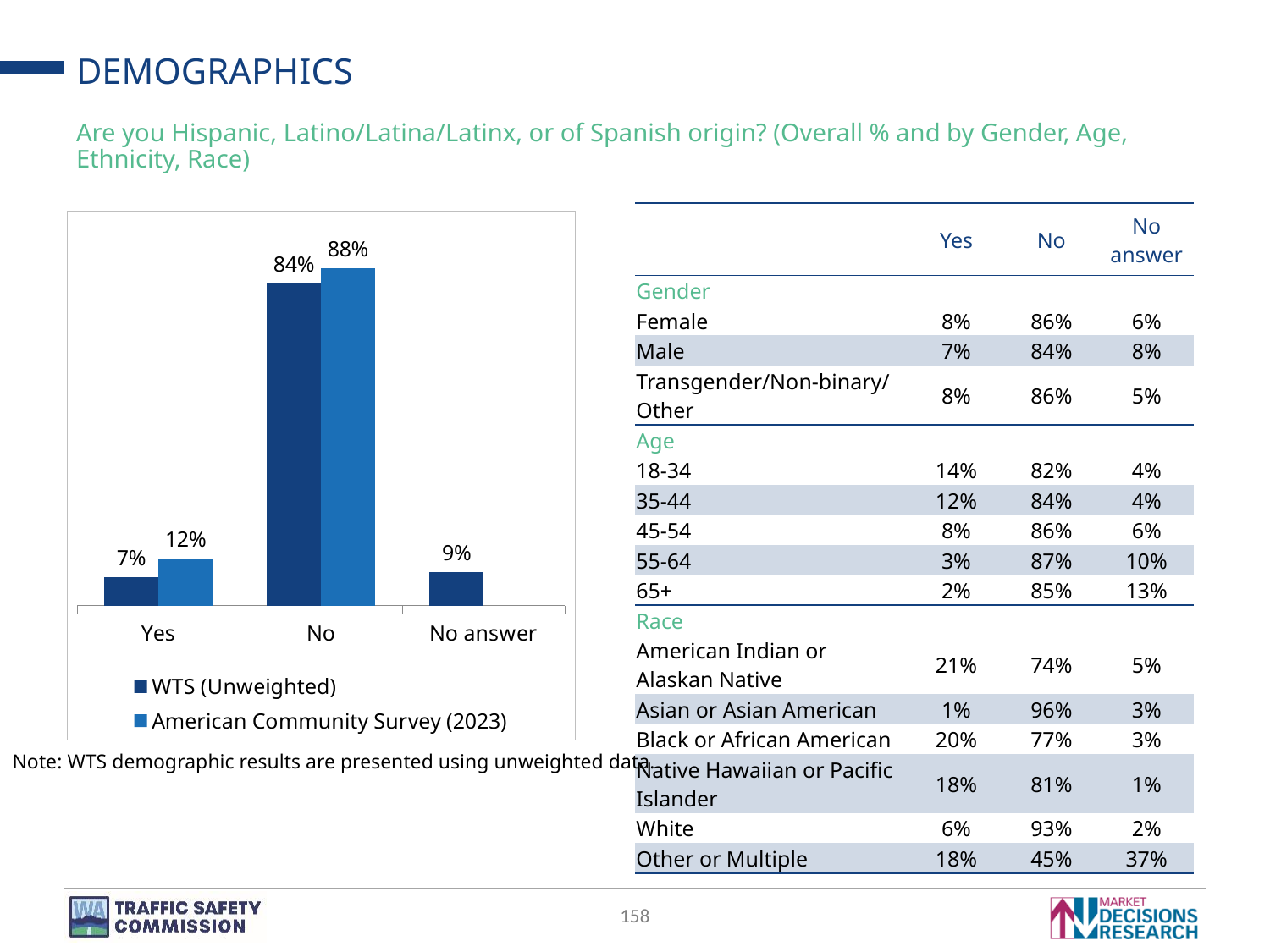
What is the American Community Survey (2023) value for the "Yes" category? 12% What is the difference between the American Community Survey (2023) and WTS (Unweighted) values for the "Yes" category? 5% What type of chart is shown on the slide? Bar chart What is the WTS (Unweighted) value for the "No" category? 84% How many categories are shown on the x axis of the chart? 3 For the "Yes" category, which series has the larger value: WTS (Unweighted) or American Community Survey (2023)? American Community Survey (2023) Which category has the highest WTS (Unweighted) value? No What is the difference between the American Community Survey (2023) and WTS (Unweighted) values for the "No" category? 4% Which category has the lowest WTS (Unweighted) value? Yes What is the American Community Survey (2023) value for the "No" category? 88% How many series does the chart legend list? 2 What is the WTS (Unweighted) value for "No answer"? 9%